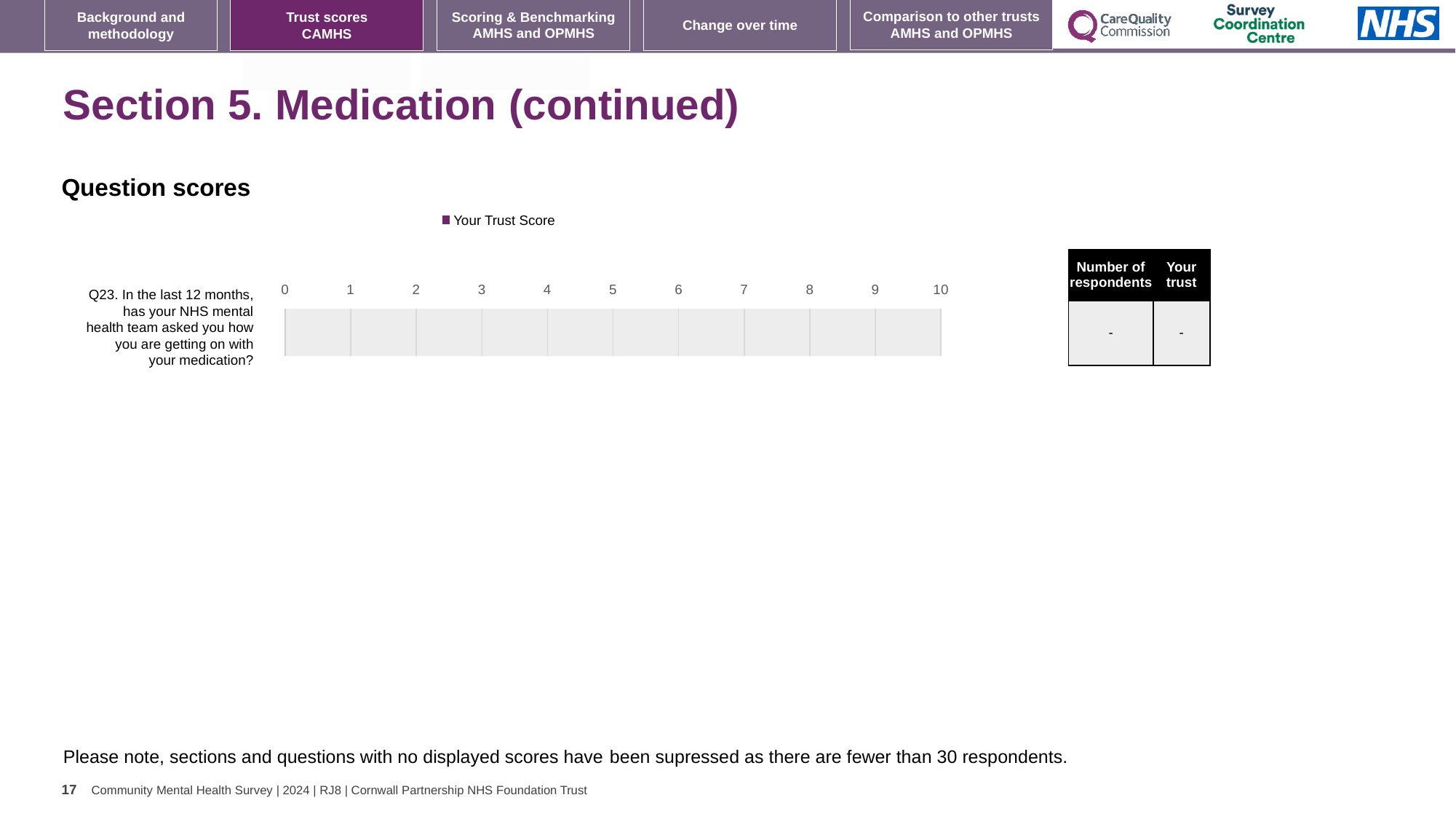
How many question categories are shown on the chart? 1 Is a bar plotted for Q23 on the chart? No What is the highest value shown on the chart's axis? 10 What value is shown for 'Number of respondents' in the table next to the chart? - What value is shown for 'Your trust' in the table next to the chart? - How many series does the chart legend list? 1 What is the name of the series shown in the chart legend? Your Trust Score